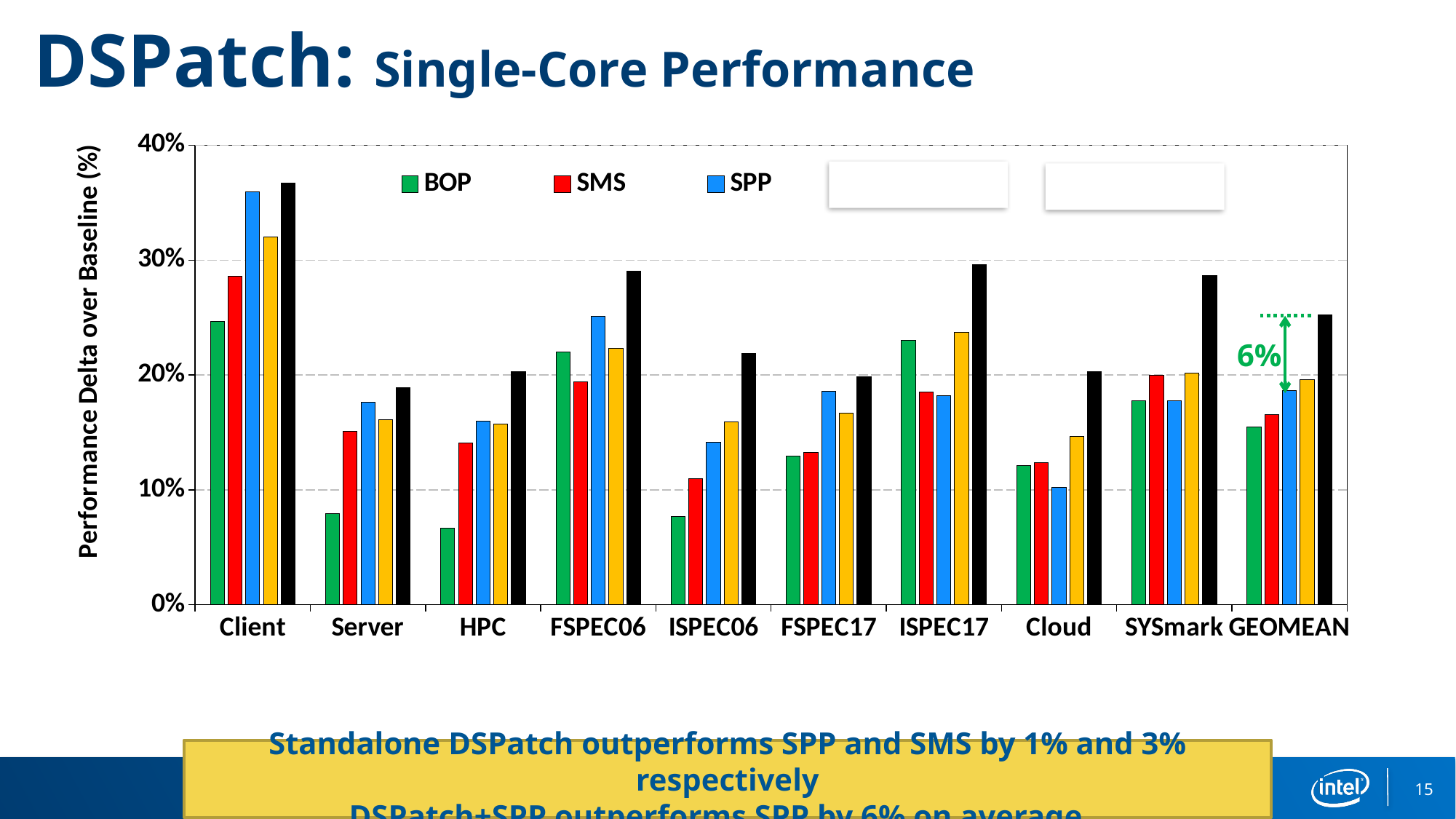
Is the BOP value for Cloud greater or less than 10%? greater For FSPEC06, which is larger: the BOP value or the SMS value? BOP Which category has the highest SPP value? Client Is the SPP value for Server greater or less than 20%? less For Client, which is larger: the SPP value or the SMS value? SPP Is the SPP value for FSPEC06 greater or less than 20%? greater Which category has the highest SMS value? Client Which category has the lowest SPP value? Cloud What is the label of the y axis of the chart? Performance Delta over Baseline (%) What kind of chart is shown on the slide? bar chart How many categories are shown along the x axis of the chart? 10